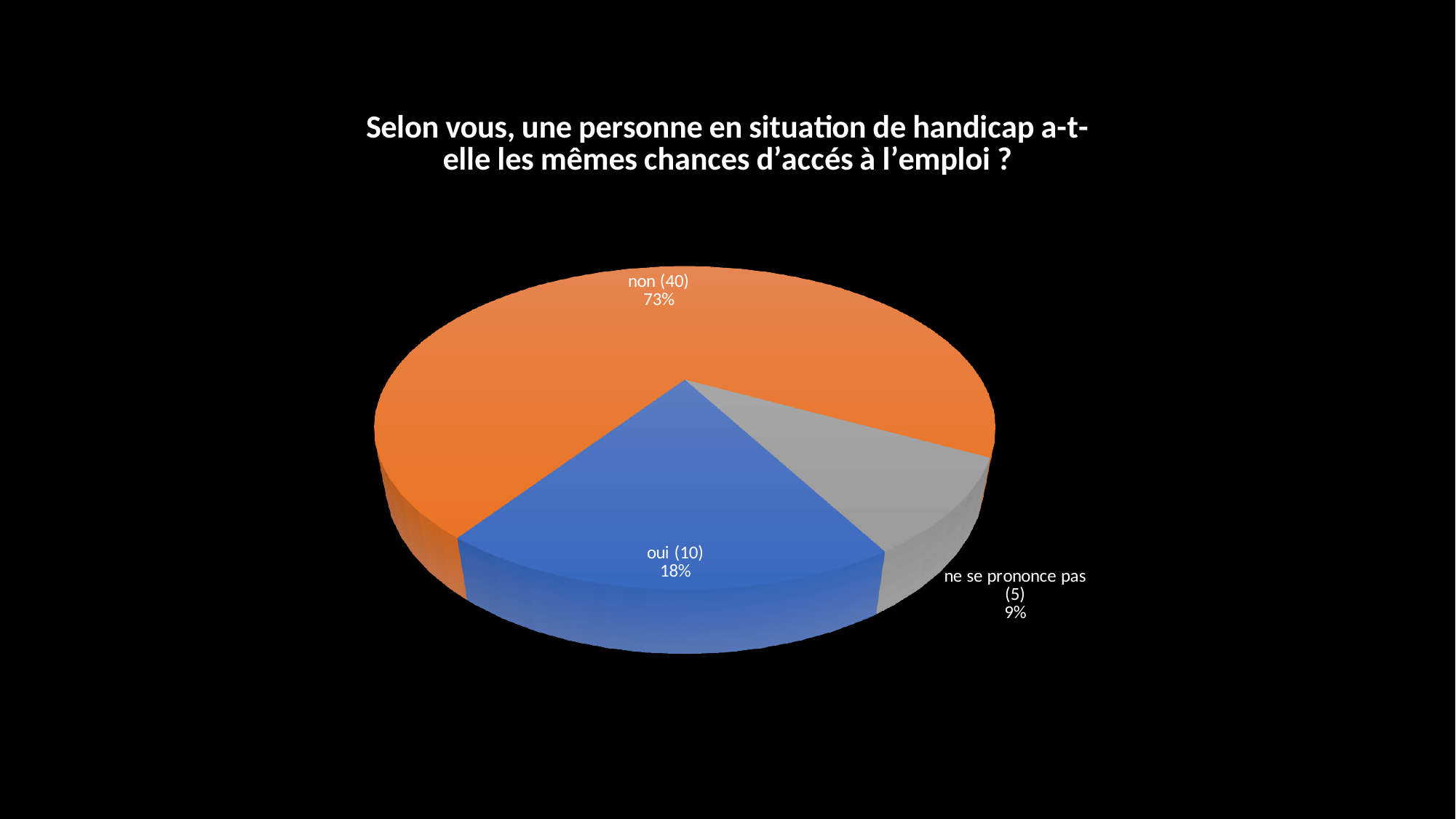
How many slices does the pie chart have? 3 What percentage of the pie does the "oui" slice represent? 18% What is the difference in respondent count between "non" and "oui"? 30 What kind of chart is shown on the slide? pie chart Which category has the smallest slice of the pie? ne se prononce pas What percentage of the pie does the "non" slice represent? 73% How many respondents answered "oui"? 10 How many respondents are in the "ne se prononce pas" category? 5 Which category has the largest slice of the pie? non How many respondents answered "non"? 40 What percentage of the pie does the "ne se prononce pas" slice represent? 9% Which slice is larger, "oui" or "ne se prononce pas"? oui